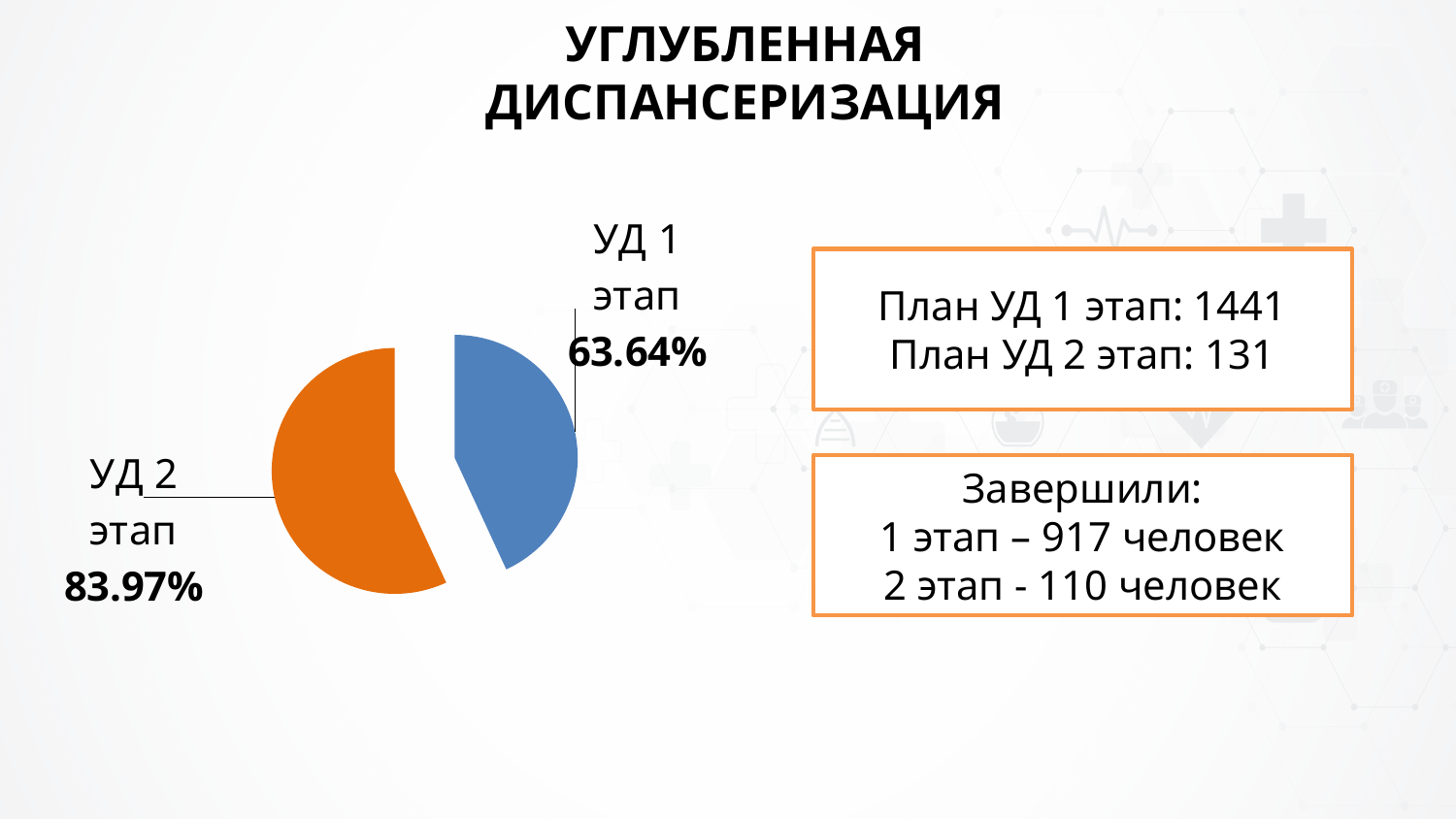
What colour is the УД 2 этап slice? Orange Which is larger, the value for УД 1 этап or for УД 2 этап? УД 2 этап What kind of chart is shown on the slide? Pie chart Which slice has the lowest value? УД 1 этап What value is shown for the УД 2 этап slice? 83.97% Which slice has the highest value? УД 2 этап What value is shown for the УД 1 этап slice? 63.64% How many slices does the pie chart have? 2 What colour is the УД 1 этап slice? Blue What is the difference between the values for УД 2 этап and УД 1 этап? 20.33%